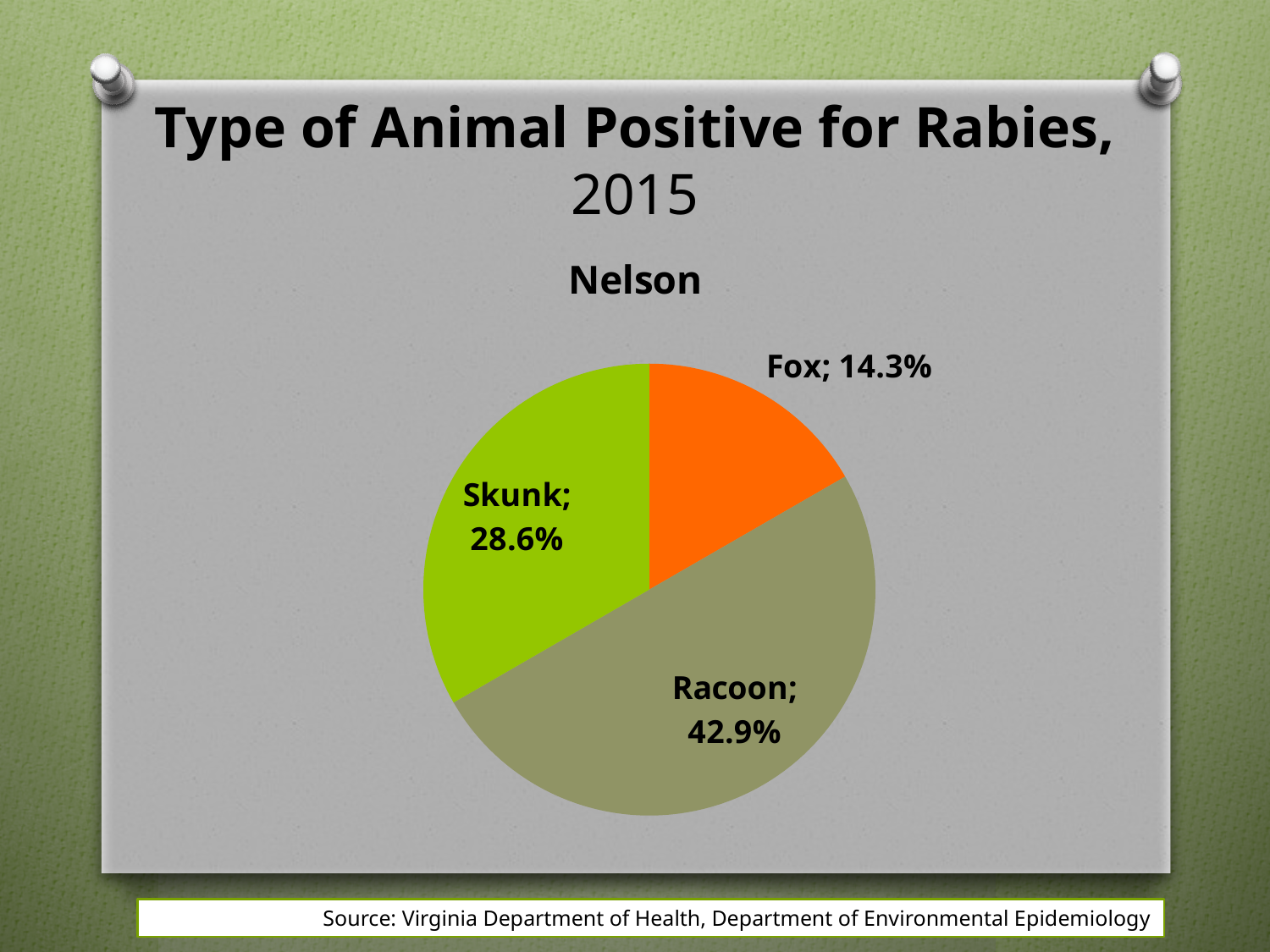
What percentage of the pie is Racoon? 42.9% Which animal has the largest share of the pie? Racoon Which animal has the smallest share of the pie? Fox What percentage of the pie is Fox? 14.3% What is the difference in percentage points between the Skunk share and the Fox share? 14.3 What is the chart's title? Nelson How many slices does the pie chart have? 3 What percentage of the pie is Skunk? 28.6% Which is larger, the Skunk share or the Fox share? Skunk What colour is the Fox slice? orange What type of chart is shown on the slide? pie chart What is the difference in percentage points between the Racoon share and the Skunk share? 14.3